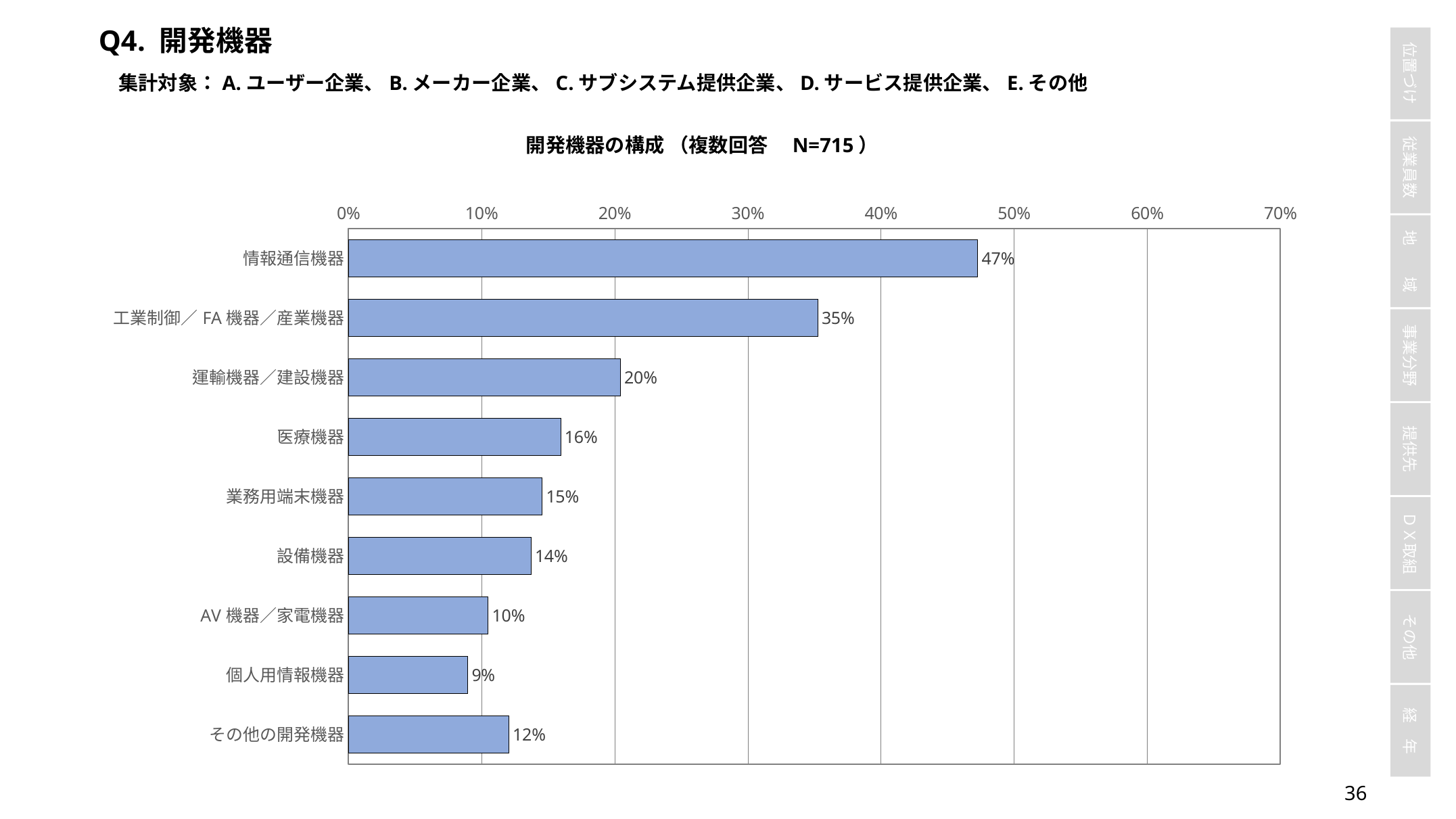
Which category has the highest value? 情報通信機器 What is the value for 情報通信機器? 47% Which is larger, the value for 運輸機器／建設機器 or the value for 業務用端末機器? 運輸機器／建設機器 What is the N value shown in the chart title? 715 Is the value for 工業制御／FA機器／産業機器 greater or less than 30%? greater What kind of chart is shown on the slide? bar chart Which category has the lowest value? 個人用情報機器 How many categories are shown in the chart? 9 What is the value for その他の開発機器? 12% What is the value for 医療機器? 16% What is the difference between the values for 情報通信機器 and 工業制御／FA機器／産業機器? 12% What is the maximum value shown on the horizontal axis? 70%